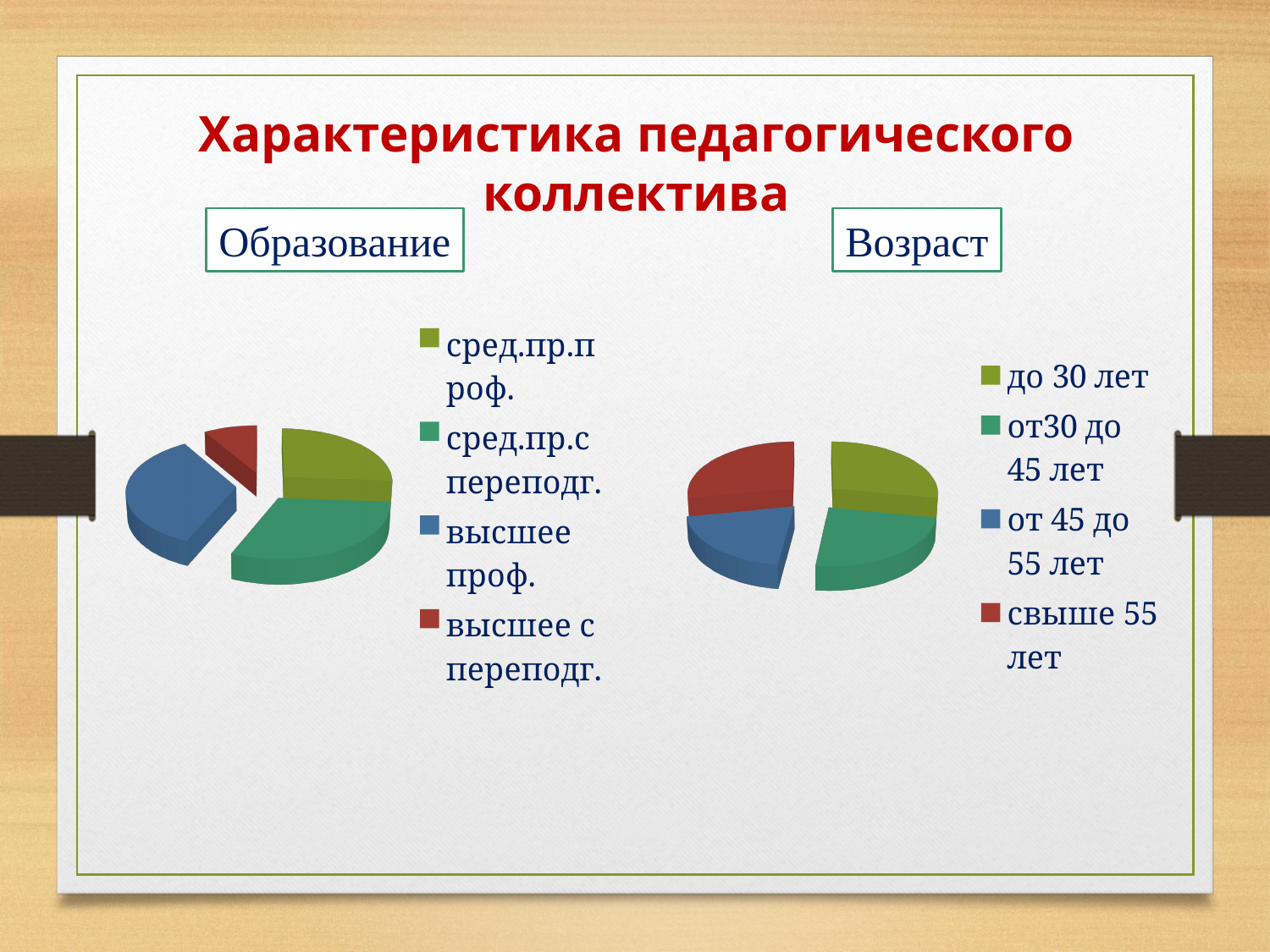
What kind of chart is the "Возраст" chart on the right? pie chart In the "Образование" pie chart, which category has the smallest slice? высшее с переподг. In the "Возраст" chart, which colour represents "свыше 55 лет"? red How many slices does the "Образование" pie chart have? 4 In the "Образование" pie chart, which category has the largest slice? высшее проф. In the "Образование" pie chart, which slice is larger: "сред.пр.с переподг." or "высшее с переподг."? сред.пр.с переподг. What kind of chart is the "Образование" chart on the left? pie chart How many entries does the legend of the "Возраст" chart list? 4 How many slices does the "Возраст" pie chart have? 4 How many entries does the legend of the "Образование" chart list? 4 What is the title shown above the left pie chart? Образование